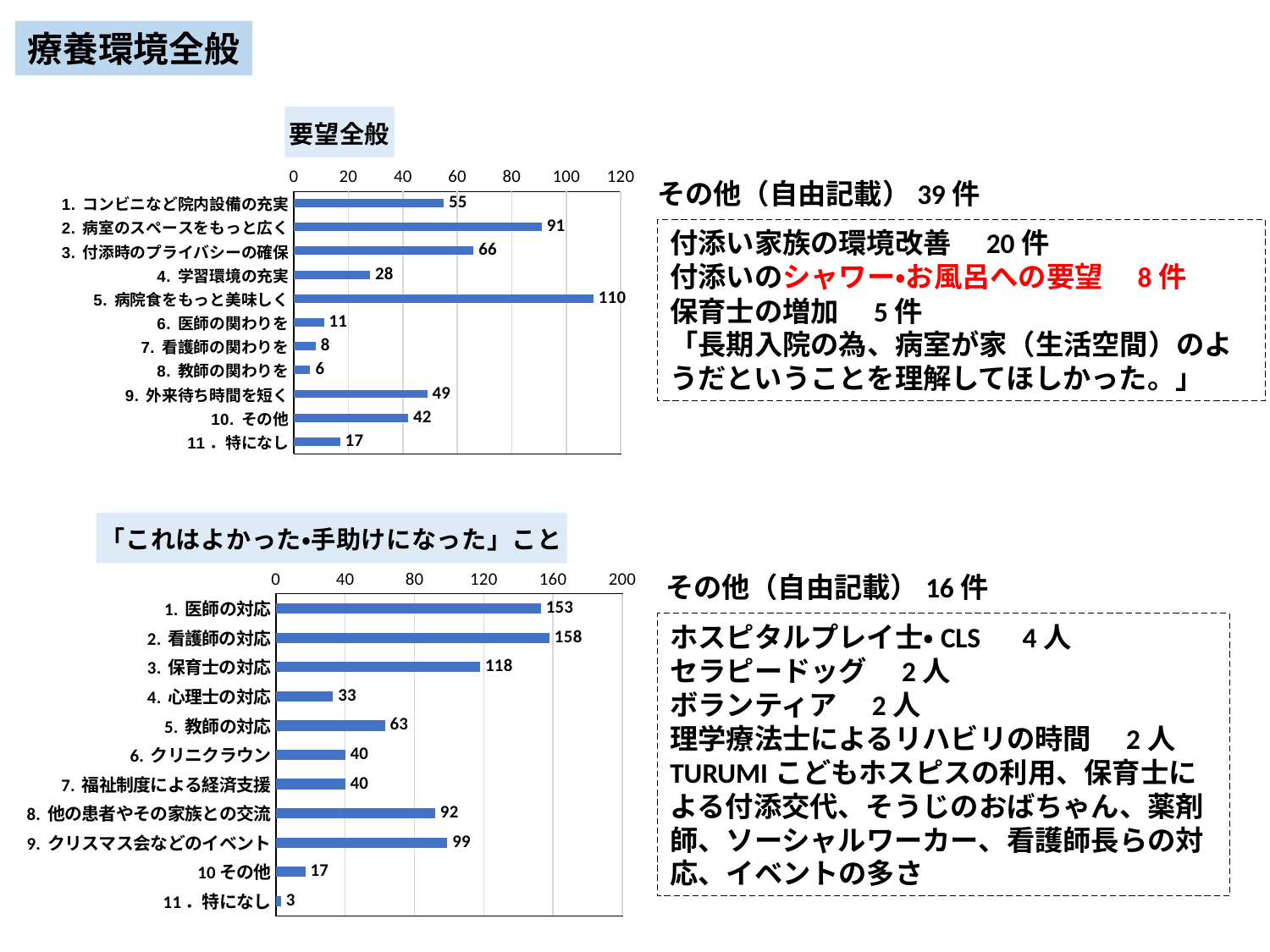
In the bottom chart (「これはよかった・手助けになった」こと), what is the value for 3. 保育士の対応? 118 In the top chart (要望全般), which category has the highest value? 5. 病院食をもっと美味しく In the top chart (要望全般), what is the difference between 2. 病室のスペースをもっと広く and 3. 付添時のプライバシーの確保? 25 In the top chart (要望全般), how many categories are plotted? 11 In the top chart (要望全般), which category has the lowest value? 8. 教師の関わりを What kind of chart is the bottom chart (「これはよかった・手助けになった」こと)? Bar chart In the bottom chart (「これはよかった・手助けになった」こと), which is larger: 8. 他の患者やその家族との交流 or 9. クリスマス会などのイベント? 9. クリスマス会などのイベント In the bottom chart (「これはよかった・手助けになった」こと), what is the difference between 1. 医師の対応 and 5. 教師の対応? 90 In the bottom chart (「これはよかった・手助けになった」こと), which category has the lowest value? 11. 特になし What is the title of the top chart on the slide? 要望全般 In the bottom chart (「これはよかった・手助けになった」こと), which category has the highest value? 2. 看護師の対応 In the top chart (要望全般), what is the value for 5. 病院食をもっと美味しく? 110